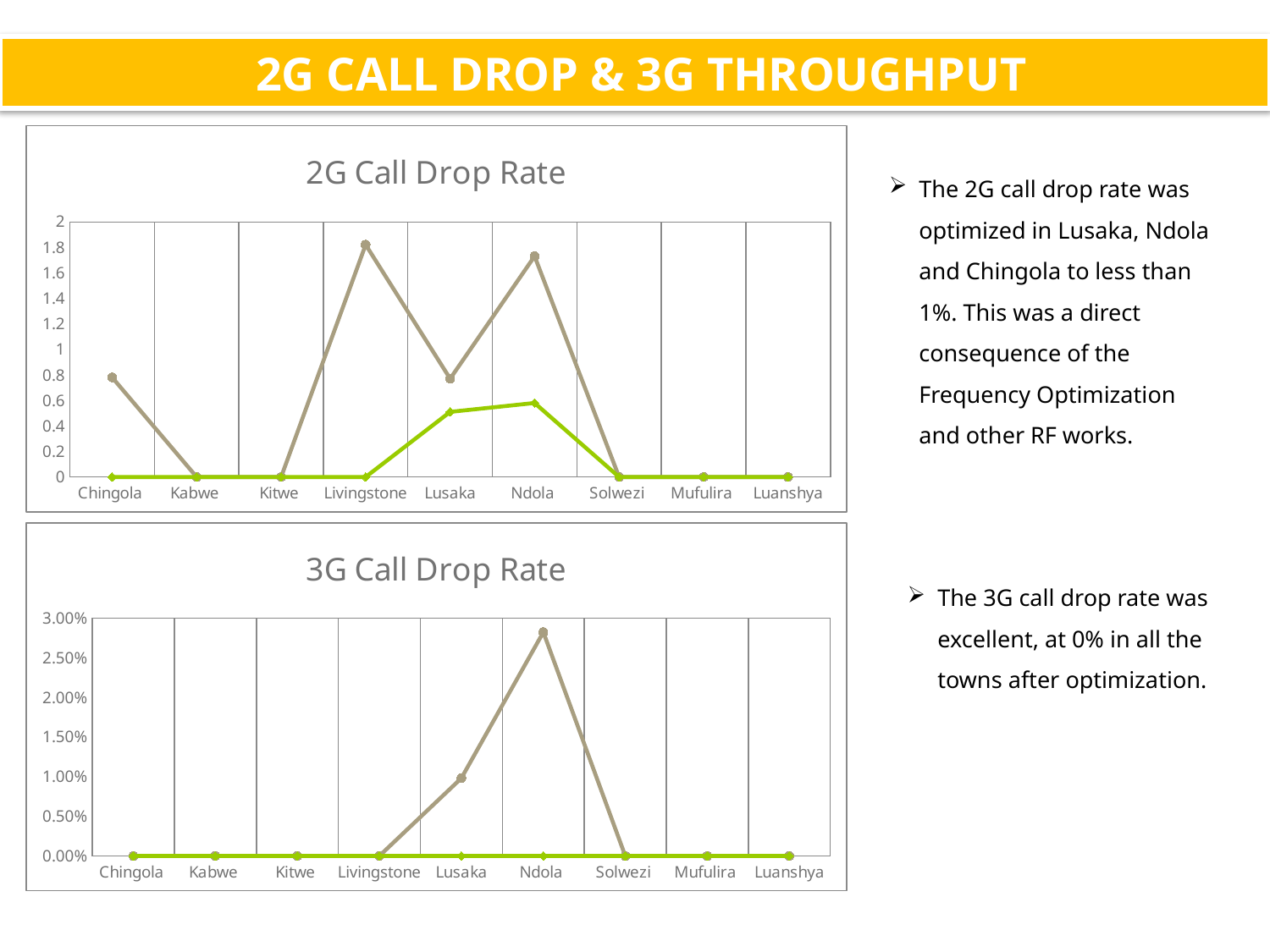
In the 2G Call Drop Rate chart, which is larger on the grey line: Livingstone or Lusaka? Livingstone In the 2G Call Drop Rate chart, what is the green line's value for Kabwe? 0 In the 3G Call Drop Rate chart, is the grey line's value for Lusaka greater or less than 1.50%? less What is the title of the top chart on the slide? 2G Call Drop Rate In the 2G Call Drop Rate chart, is the grey line's value for Chingola greater or less than 1? less In the 2G Call Drop Rate chart, which town has the highest value on the grey line? Livingstone How many towns are shown on the x axis of the 2G Call Drop Rate chart? 9 In the 2G Call Drop Rate chart, is the grey line's value for Livingstone greater or less than 1.6? greater In the 3G Call Drop Rate chart, what is the green line's value for Ndola? 0.00% What kind of chart is the 2G Call Drop Rate chart? line chart In the 3G Call Drop Rate chart, which town has the highest value on the grey line? Ndola